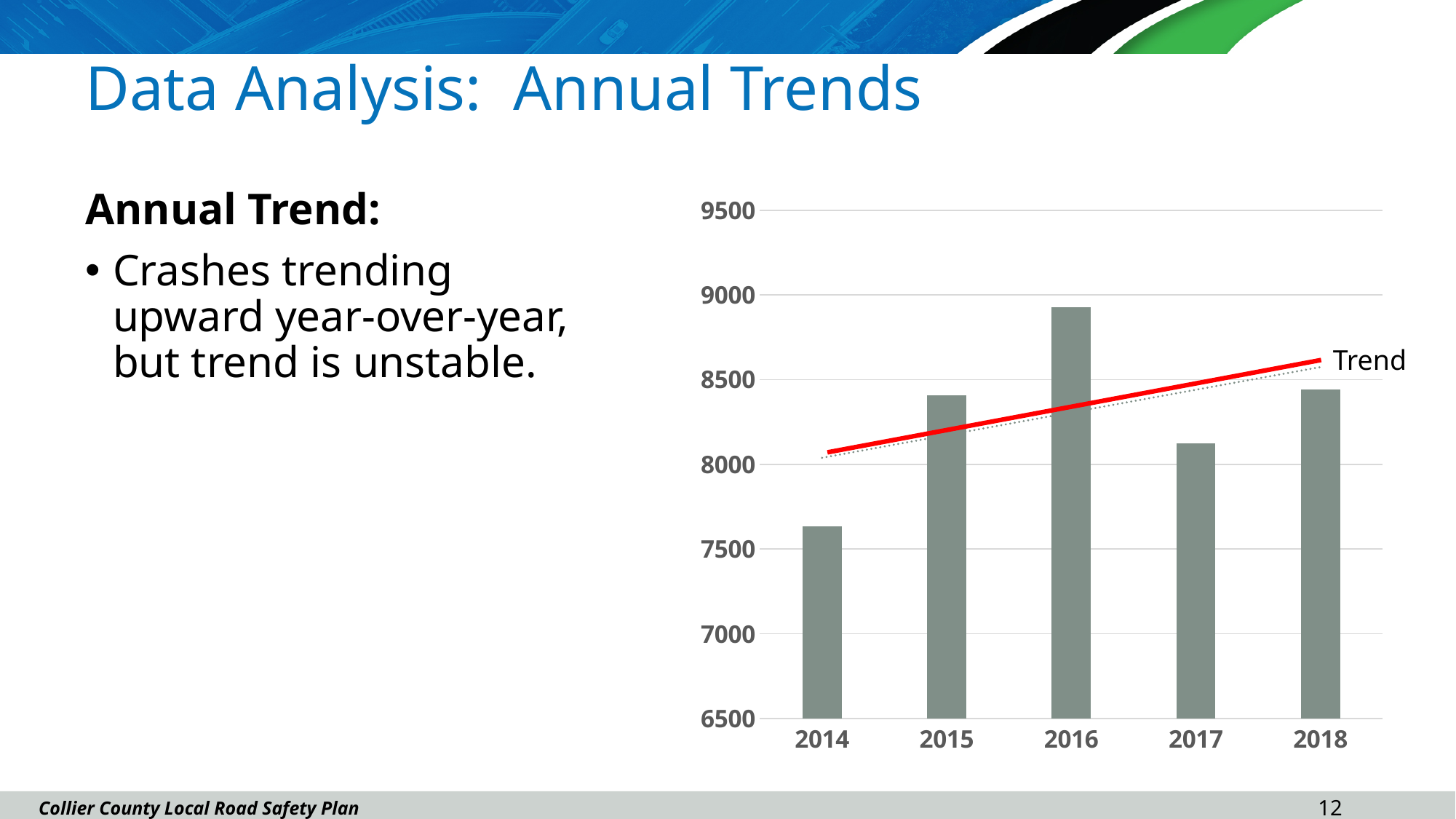
Is the value for 2017 greater or less than 8000? greater Which year has the shortest bar in the chart? 2014 How many years are shown on the x axis of the chart? 5 What label is attached to the red line in the chart? Trend Which year has the taller bar, 2016 or 2017? 2016 Which year has the tallest bar in the chart? 2016 Which year has the taller bar, 2014 or 2015? 2015 Is the value for 2014 greater or less than 8000? less Is the value for 2016 greater or less than 8500? greater Does the red line in the chart rise or fall from 2014 to 2018? rise What kind of chart is shown on the slide? bar chart What is the lowest value shown on the chart's vertical axis? 6500